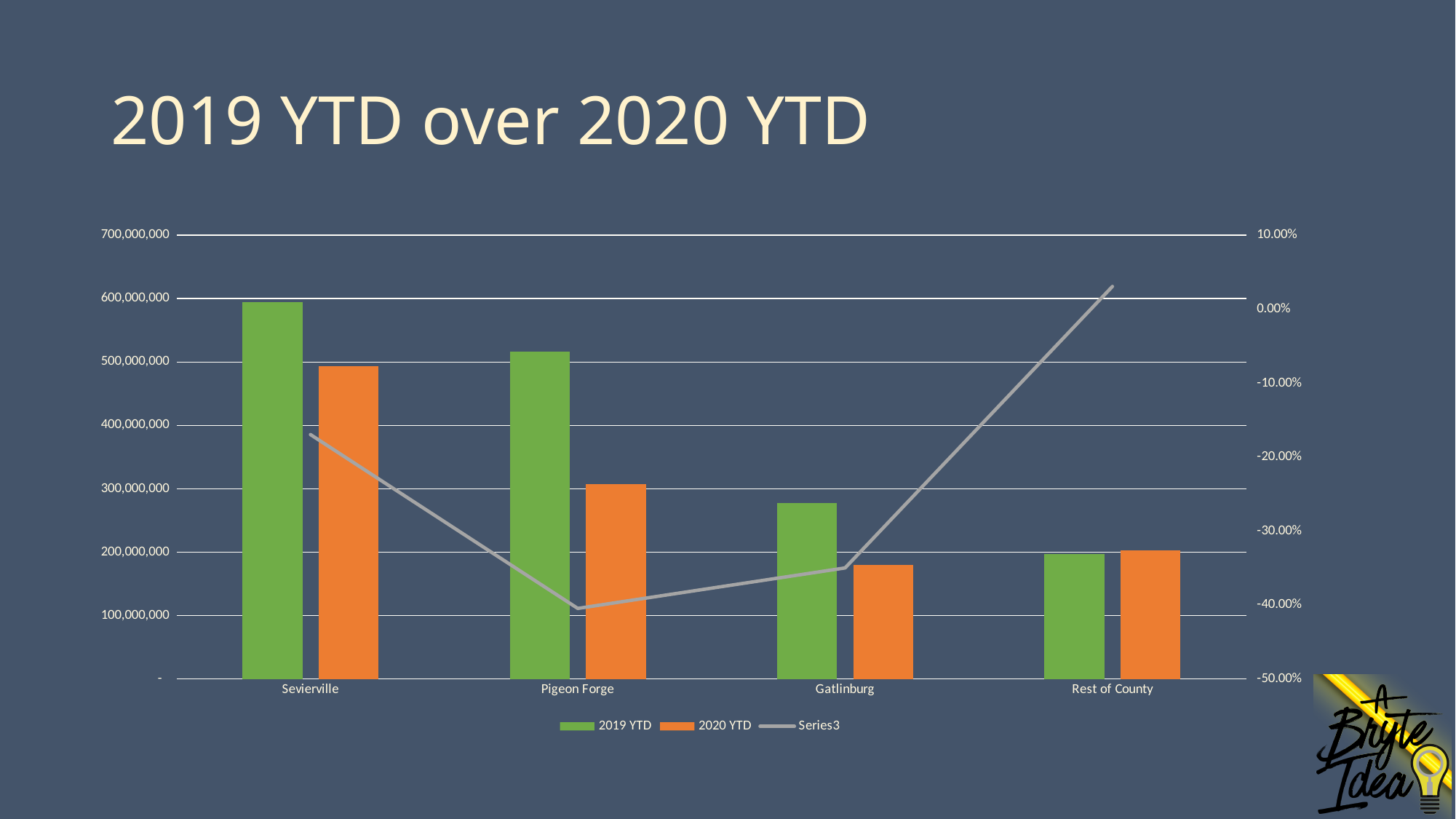
How many categories are shown on the x axis? 4 Which category has the lowest 2019 YTD bar? Rest of County For Pigeon Forge, which is larger: the 2019 YTD bar or the 2020 YTD bar? 2019 YTD What kind of chart is this? Bar chart with a line series Is the 2019 YTD value for Sevierville greater or less than 500,000,000? greater Which category has the lowest 2020 YTD bar? Gatlinburg Is the 2020 YTD value for Pigeon Forge greater or less than 400,000,000? less At which category does the Series3 line reach its lowest point? Pigeon Forge Which category has the highest 2019 YTD bar? Sevierville How many series does the legend list? 3 Is the Series3 value for Sevierville greater or less than -10.00%? less What is the title of the chart? 2019 YTD over 2020 YTD